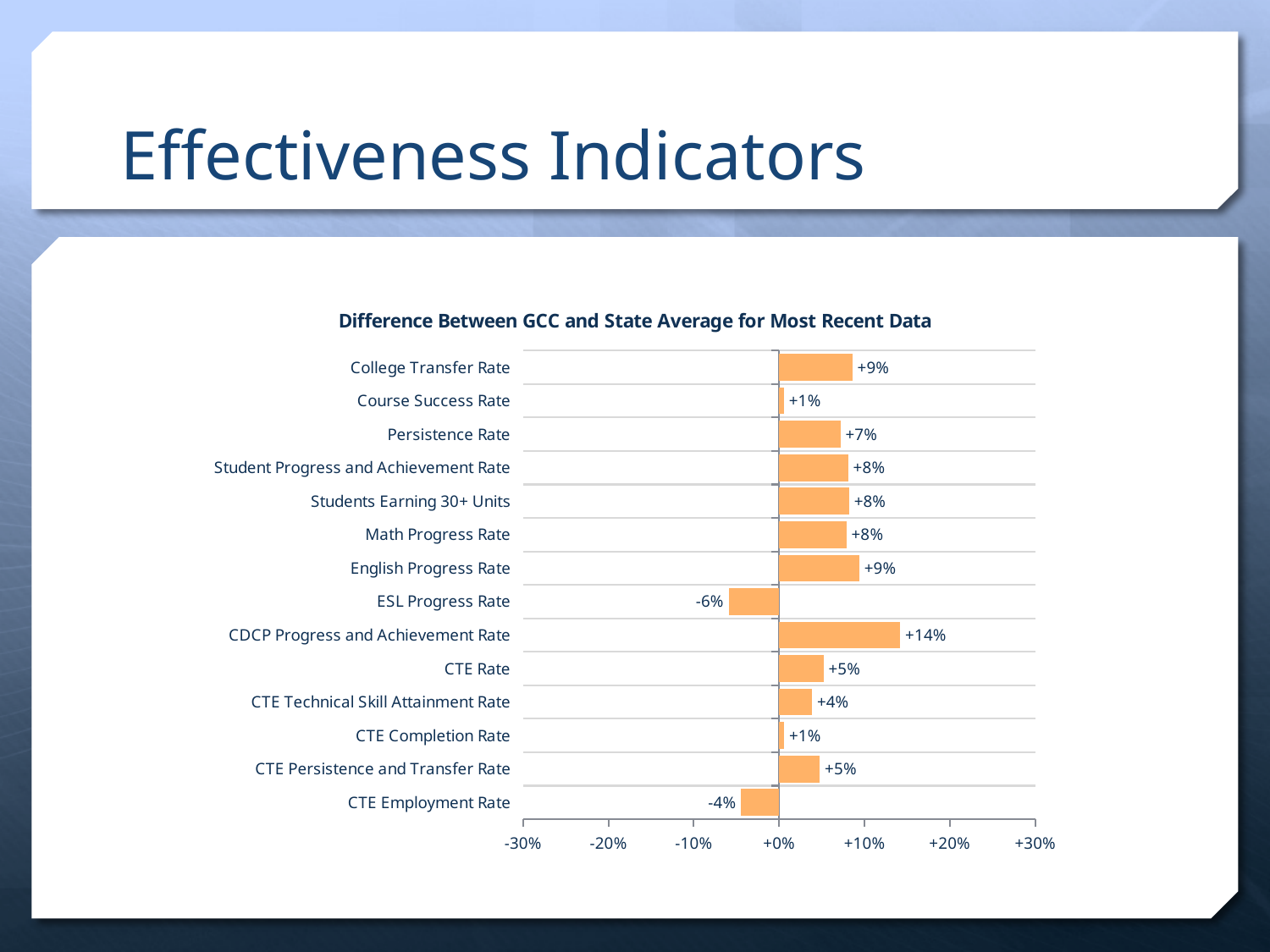
What is the title of the chart? Difference Between GCC and State Average for Most Recent Data What is the value for CTE Employment Rate? -4% Which is larger, the value for CTE Rate or the value for CTE Technical Skill Attainment Rate? CTE Rate How many categories are shown in the chart? 14 What is the difference between the values for CDCP Progress and Achievement Rate and College Transfer Rate? 5% Which category has the lowest value? ESL Progress Rate What kind of chart is shown on the slide? Bar chart Which category has the highest value? CDCP Progress and Achievement Rate What is the value for ESL Progress Rate? -6% What is the value for CDCP Progress and Achievement Rate? +14% What is the value for Persistence Rate? +7% Is the value for CDCP Progress and Achievement Rate greater or less than +10%? greater